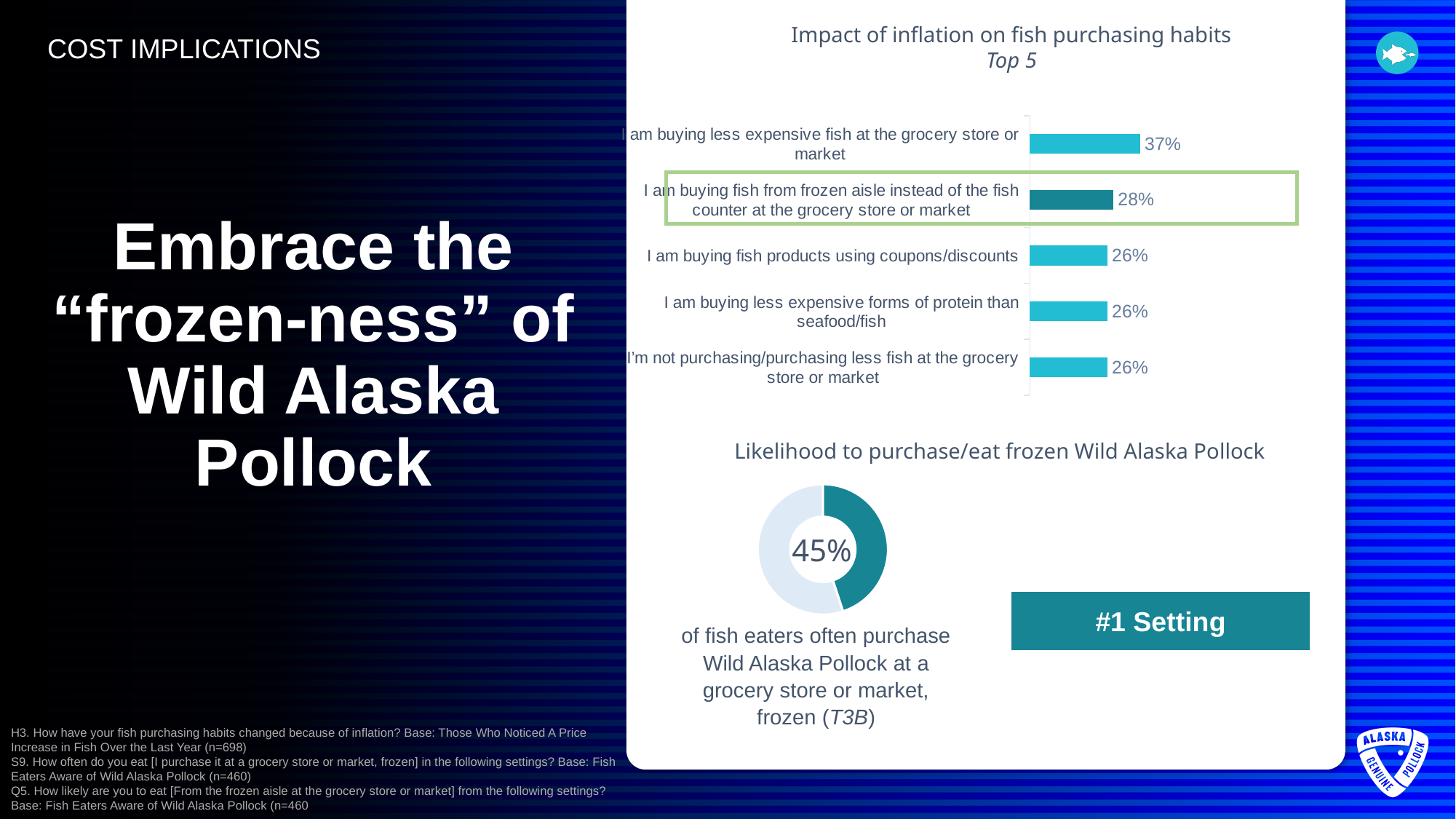
In the 'Impact of inflation on fish purchasing habits' chart, what percentage say they are buying fish products using coupons/discounts? 26% In the 'Impact of inflation on fish purchasing habits' chart, which category has the highest value? I am buying less expensive fish at the grocery store or market In the 'Impact of inflation on fish purchasing habits' chart, which is larger: buying fish from the frozen aisle or buying fish products using coupons/discounts? Buying fish from the frozen aisle What type of chart is the 'Impact of inflation on fish purchasing habits' chart? Bar chart In the 'Impact of inflation on fish purchasing habits' chart, what percentage of respondents say they are buying less expensive fish at the grocery store or market? 37% In the 'Impact of inflation on fish purchasing habits' chart, which bar is highlighted with a green outline? I am buying fish from frozen aisle instead of the fish counter at the grocery store or market What type of chart is the 'Likelihood to purchase/eat frozen Wild Alaska Pollock' chart? Donut chart In the 'Impact of inflation on fish purchasing habits' chart, what percentage say they are buying fish from the frozen aisle instead of the fish counter? 28% How many categories are shown in the 'Impact of inflation on fish purchasing habits' chart? 5 In the 'Impact of inflation on fish purchasing habits' chart, how many categories share the value 26%? 3 In the 'Likelihood to purchase/eat frozen Wild Alaska Pollock' chart, what percentage of fish eaters often purchase Wild Alaska Pollock at a grocery store or market, frozen? 45% In the 'Impact of inflation on fish purchasing habits' chart, what is the difference between the highest value and the value for buying fish from the frozen aisle? 9%